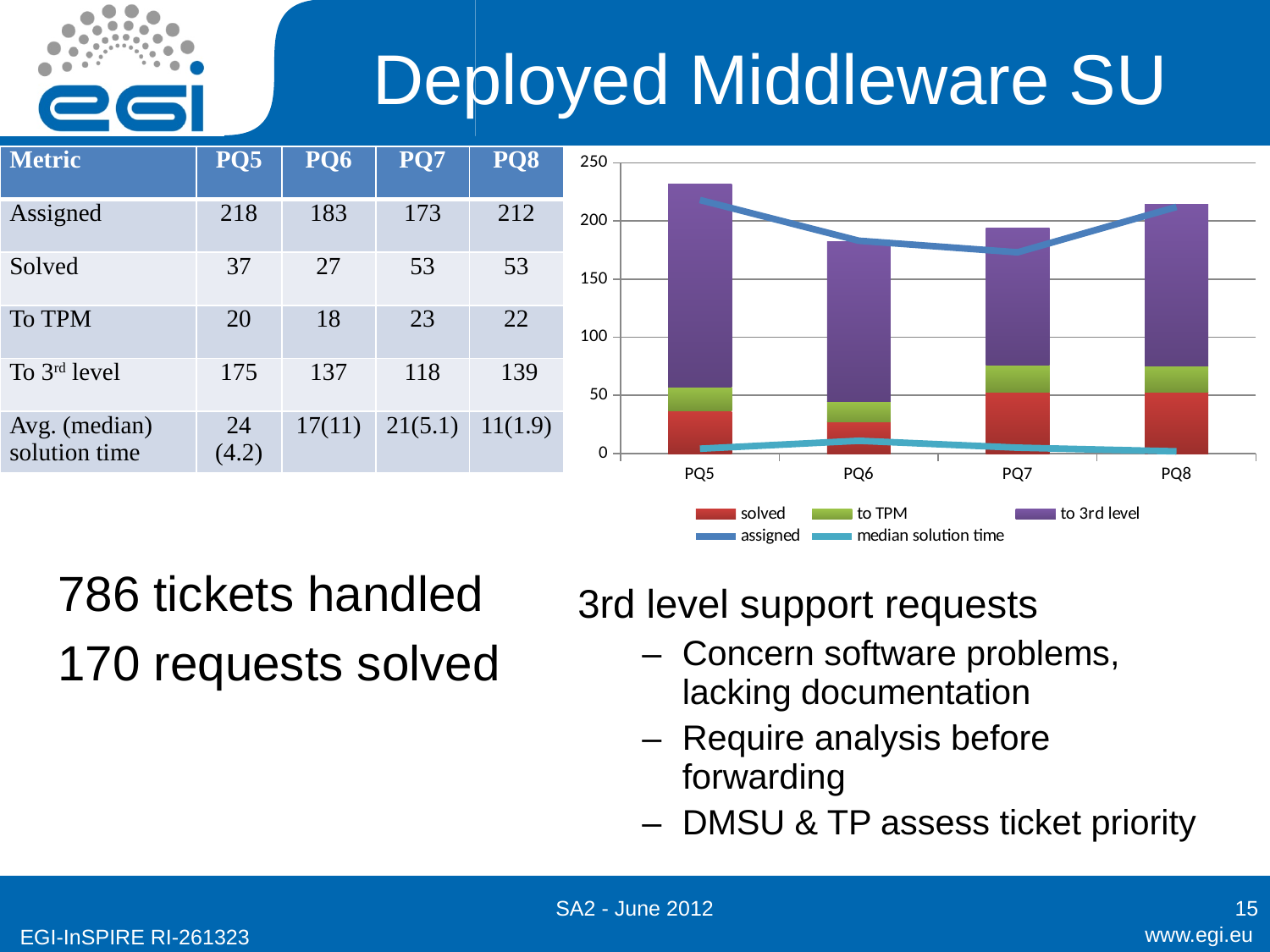
How many series does the chart legend list? 5 What colour represents the 'solved' series in the chart? red Which quarter has the larger 'solved' segment, PQ6 or PQ7? PQ7 Which quarter has the shortest stacked bar in the chart? PQ6 What kind of chart is shown on the slide? combination bar and line chart (stacked bars with lines) Is the total height of the stacked bar for PQ5 greater or less than 200? greater According to the slide, what is the 'Solved' value for PQ7? 53 Which quarter has the tallest stacked bar in the chart? PQ5 Which quarter has the larger 'to 3rd level' segment, PQ5 or PQ8? PQ5 How many quarters (categories) are shown on the x axis of the chart? 4 Is the total height of the stacked bar for PQ6 greater or less than 200? less Does the 'assigned' line rise or fall from PQ5 to PQ7? fall